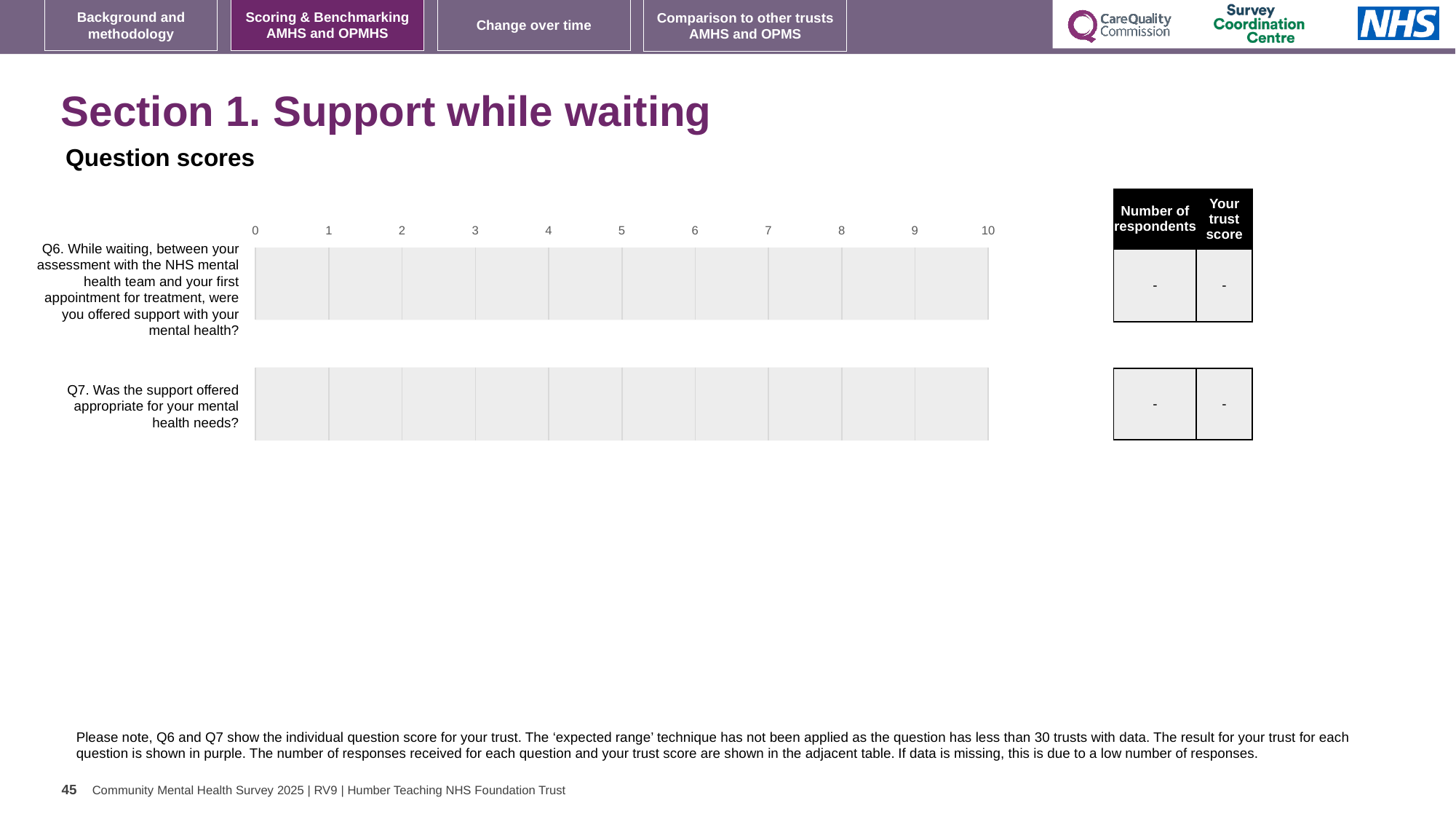
What is the lowest value shown on the chart's horizontal axis? 0 What is the trust score shown in the table for Q6? - What is the highest value shown on the chart's horizontal axis? 10 What is the number of respondents shown in the table for Q7? - How many questions (categories) are listed on the chart? 2 Are any bars plotted for Q6 or Q7 on the chart? No